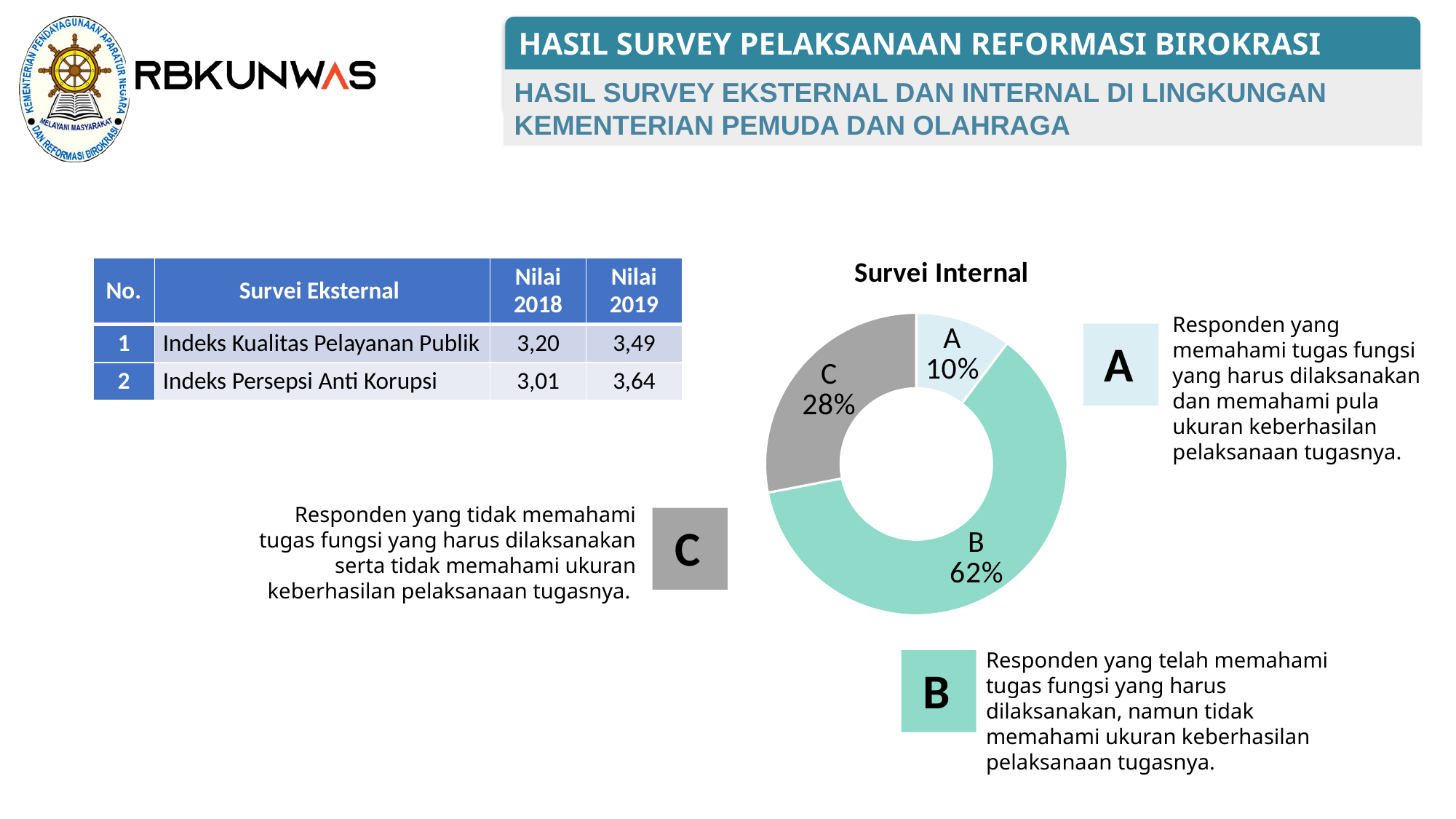
Which category has the largest share in the Survei Internal chart? B Which category has the smallest share in the Survei Internal chart? A In the Survei Internal chart, what share does category A have? 10% In the Survei Internal chart, what is the difference between the shares of B and C? 34% In the Survei Internal chart, what is the difference between the shares of C and A? 18% What is the title of the chart on the slide? Survei Internal In the Survei Internal chart, what share does category C have? 28% In the Survei Internal chart, what share does category B have? 62% What kind of chart is the Survei Internal chart? doughnut chart How many categories are shown in the Survei Internal chart? 3 In the Survei Internal chart, which is larger, the share of C or the share of A? C What colour is the slice for category B in the Survei Internal chart? teal (light green)